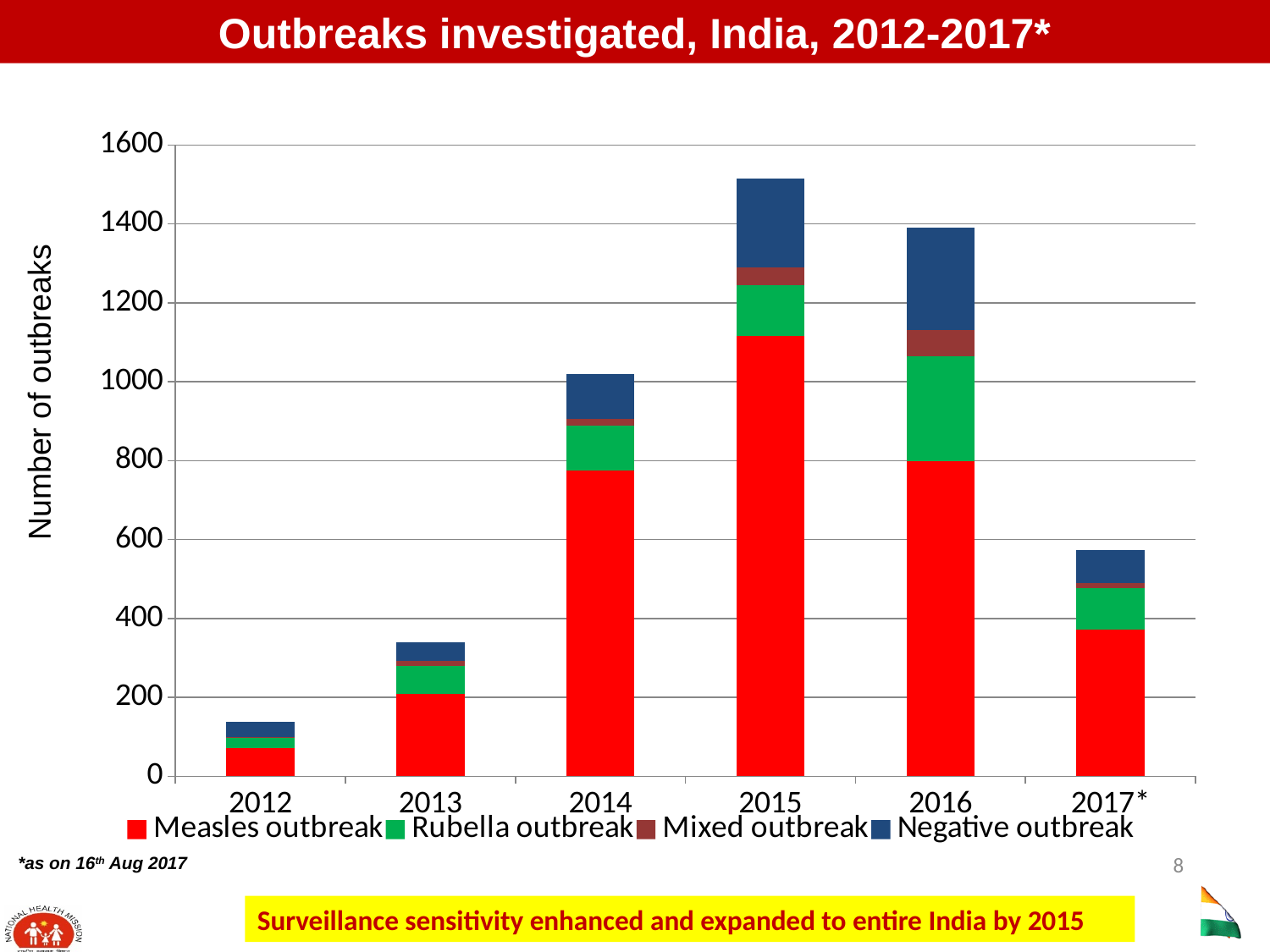
Is the total number of outbreaks for 2017* greater or less than 400? greater Which year has the lowest total number of outbreaks investigated? 2012 How many years are shown on the x axis? 6 Which year has a larger total number of outbreaks, 2015 or 2016? 2015 What kind of chart is shown on the slide? Stacked bar chart Is the total number of outbreaks for 2015 greater or less than 1400? greater Is the total number of outbreaks for 2012 greater or less than 200? less Which series is shown in red in the chart? Measles outbreak Which year has the highest total number of outbreaks investigated? 2015 How many series does the legend list? 4 Do the total outbreaks rise or fall from 2012 to 2015? rise